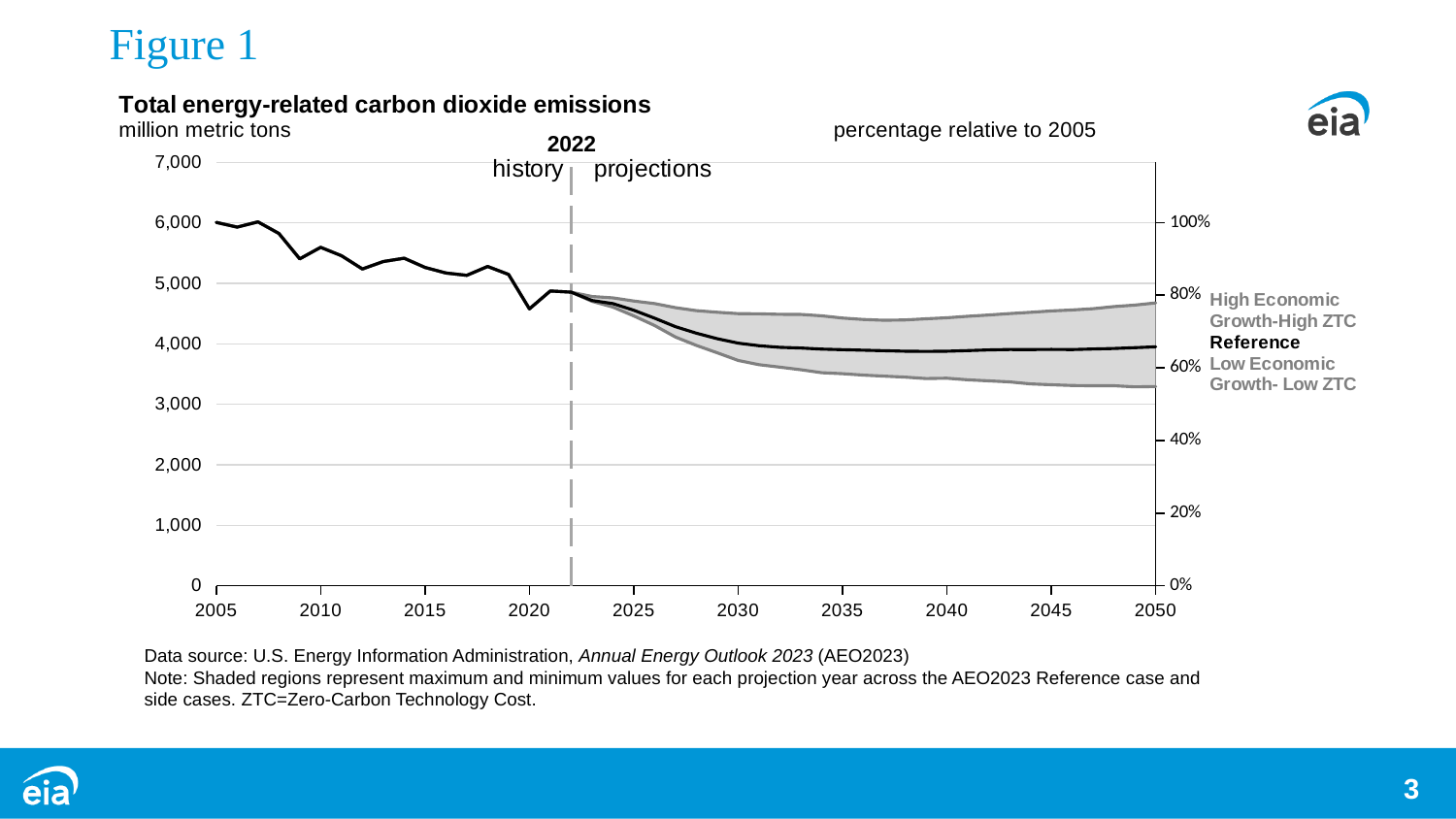
Do the historical emissions values rise or fall from 2005 to 2022? fall What unit is shown on the left vertical axis of the chart? million metric tons Which year has higher emissions: 2005 or 2050 in the Reference case? 2005 Which year does the dashed vertical line separating history from projections mark? 2022 Is the Reference case value in 2050 greater or less than 3,000 million metric tons? greater Is the High Economic Growth-High ZTC value in 2050 greater or less than 5,000 million metric tons? less Is the Reference case value in 2050 greater or less than 5,000 million metric tons? less What is the title of the chart? Total energy-related carbon dioxide emissions Which is larger in 2050: the High Economic Growth-High ZTC value or the Low Economic Growth-Low ZTC value? High Economic Growth-High ZTC What kind of chart is shown on the slide? line chart How many projection series are labeled on the right side of the chart? 3